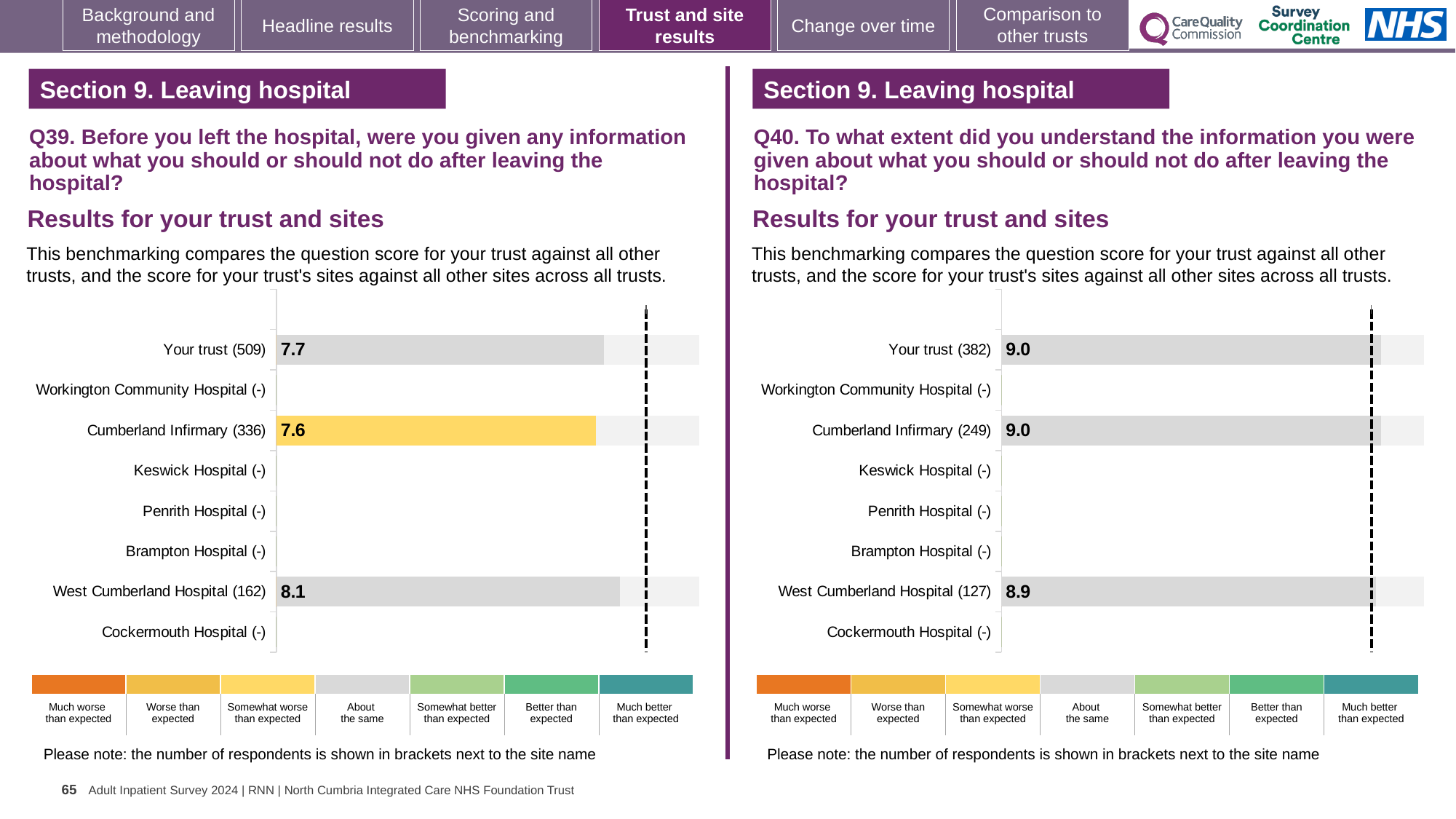
In the Q39 chart on the left, what is the score for West Cumberland Hospital? 8.1 In the Q39 chart on the left, what is the score for Your trust? 7.7 What type of chart is used on the left for Q39? Bar chart In the Q39 chart on the left, how many respondents are shown in brackets for Cumberland Infirmary? 336 In the Q39 chart on the left, which benchmark category does the yellow colour of the Cumberland Infirmary bar correspond to in the legend? Somewhat worse than expected In the Q40 chart on the right, what is the score for Your trust? 9.0 In the Q40 chart on the right, what is the score for West Cumberland Hospital? 8.9 In the Q39 chart on the left, how many site rows (including Your trust) are listed on the vertical axis? 8 In the Q39 chart on the left, what is the score for Cumberland Infirmary? 7.6 In the Q40 chart on the right, what is the difference between the Cumberland Infirmary score and the West Cumberland Hospital score? 0.1 In the Q39 chart on the left, which site with a plotted score has the highest value? West Cumberland Hospital In the Q39 chart on the left, what is the difference between the West Cumberland Hospital score and the Cumberland Infirmary score? 0.5